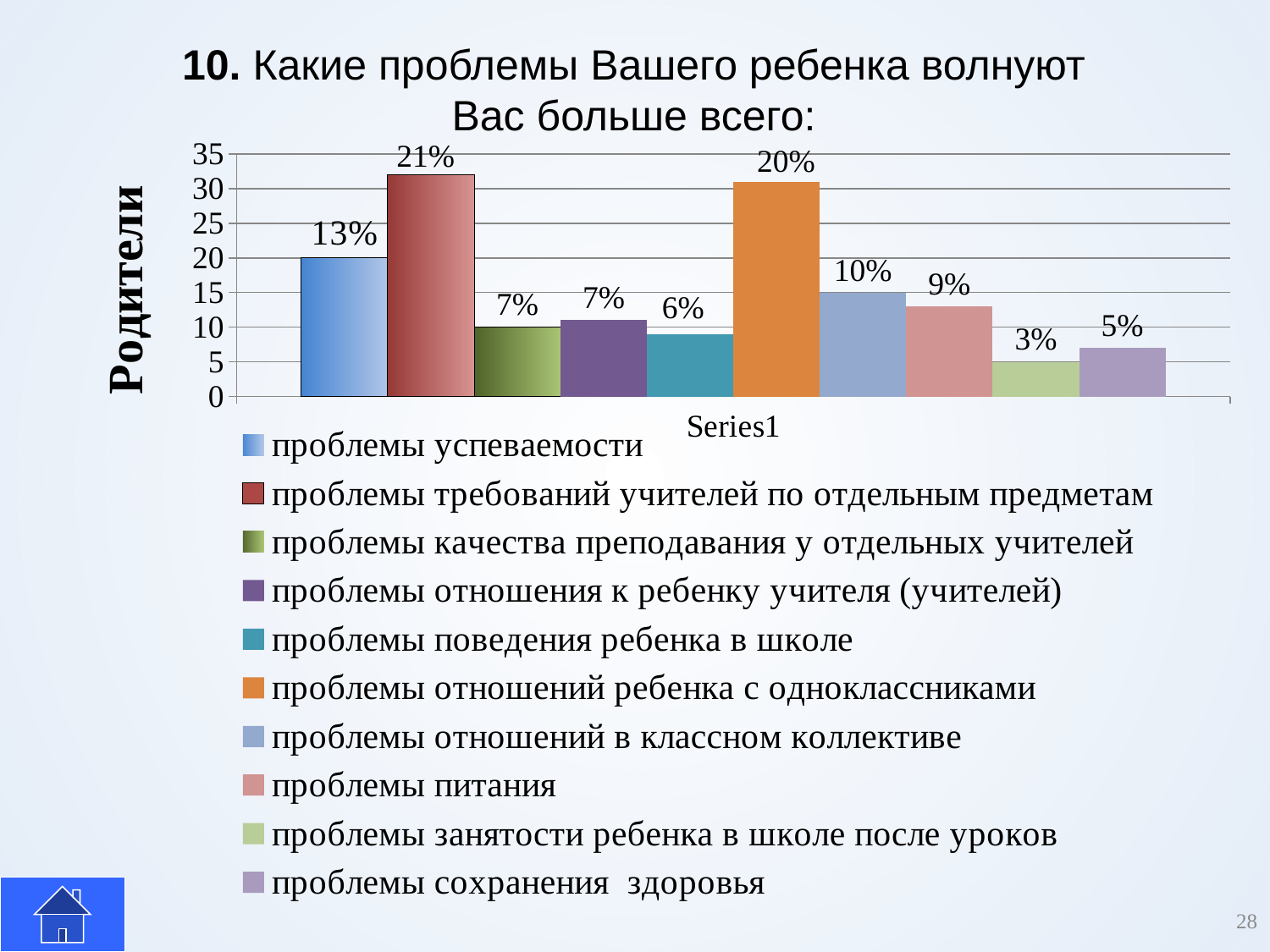
What is the data label on the bar for 'проблемы отношений ребенка с одноклассниками'? 20% What kind of chart is shown on the slide? bar chart What is the data label on the bar for 'проблемы питания'? 9% Which is larger: the value for 'проблемы отношений в классном коллективе' or for 'проблемы поведения ребенка в школе'? проблемы отношений в классном коллективе What is the data label on the bar for 'проблемы успеваемости'? 13% What is the label on the vertical axis? Родители Which series has the lowest value? проблемы занятости ребенка в школе после уроков What is the difference between the data labels for 'проблемы требований учителей по отдельным предметам' and 'проблемы успеваемости'? 8% How many series does the legend list? 10 Is the bar for 'проблемы отношений ребенка с одноклассниками' greater or less than 25 on the vertical axis? greater What is the data label on the bar for 'проблемы сохранения здоровья'? 5% Which series has the highest value? проблемы требований учителей по отдельным предметам